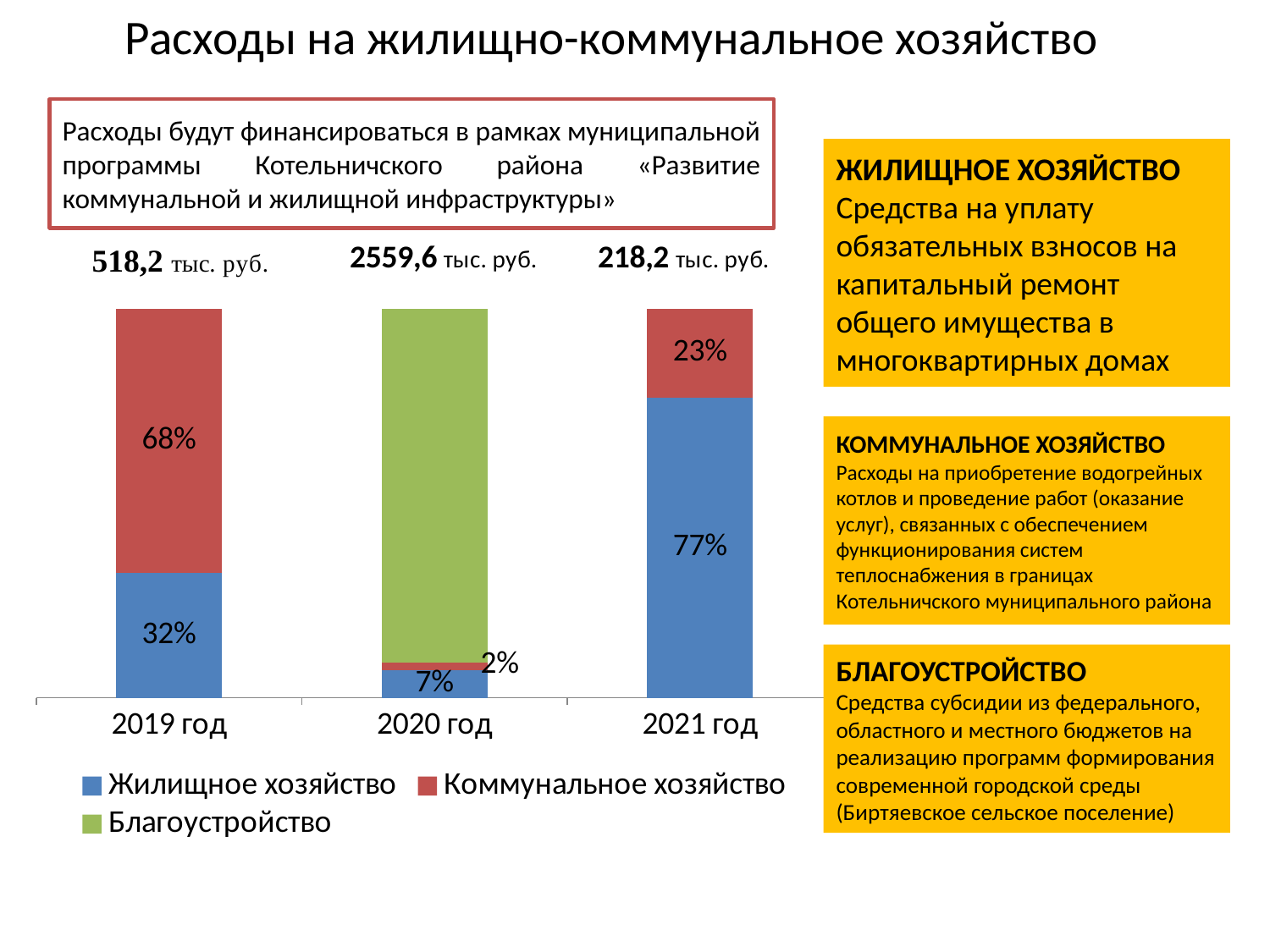
What share of expenses in 2019 год goes to Коммунальное хозяйство? 68% By how many percentage points does the Жилищное хозяйство share in 2021 год exceed its share in 2019 год? 45 percentage points How many years (categories) are shown on the x axis of the chart? 3 What is the total amount of expenses shown above the bar for 2020 год? 2559,6 тыс. руб. What share of expenses in 2020 год goes to Коммунальное хозяйство? 2% How many series does the chart legend list? 3 Which year has the largest total expenses shown above the bars? 2020 год Which series takes the largest share of the bar for 2020 год? Благоустройство What share of expenses in 2019 год goes to Жилищное хозяйство? 32% What share of expenses in 2021 год goes to Жилищное хозяйство? 77% What kind of chart is shown on the slide? Stacked bar chart Which year has the smallest total expenses shown above the bars? 2021 год